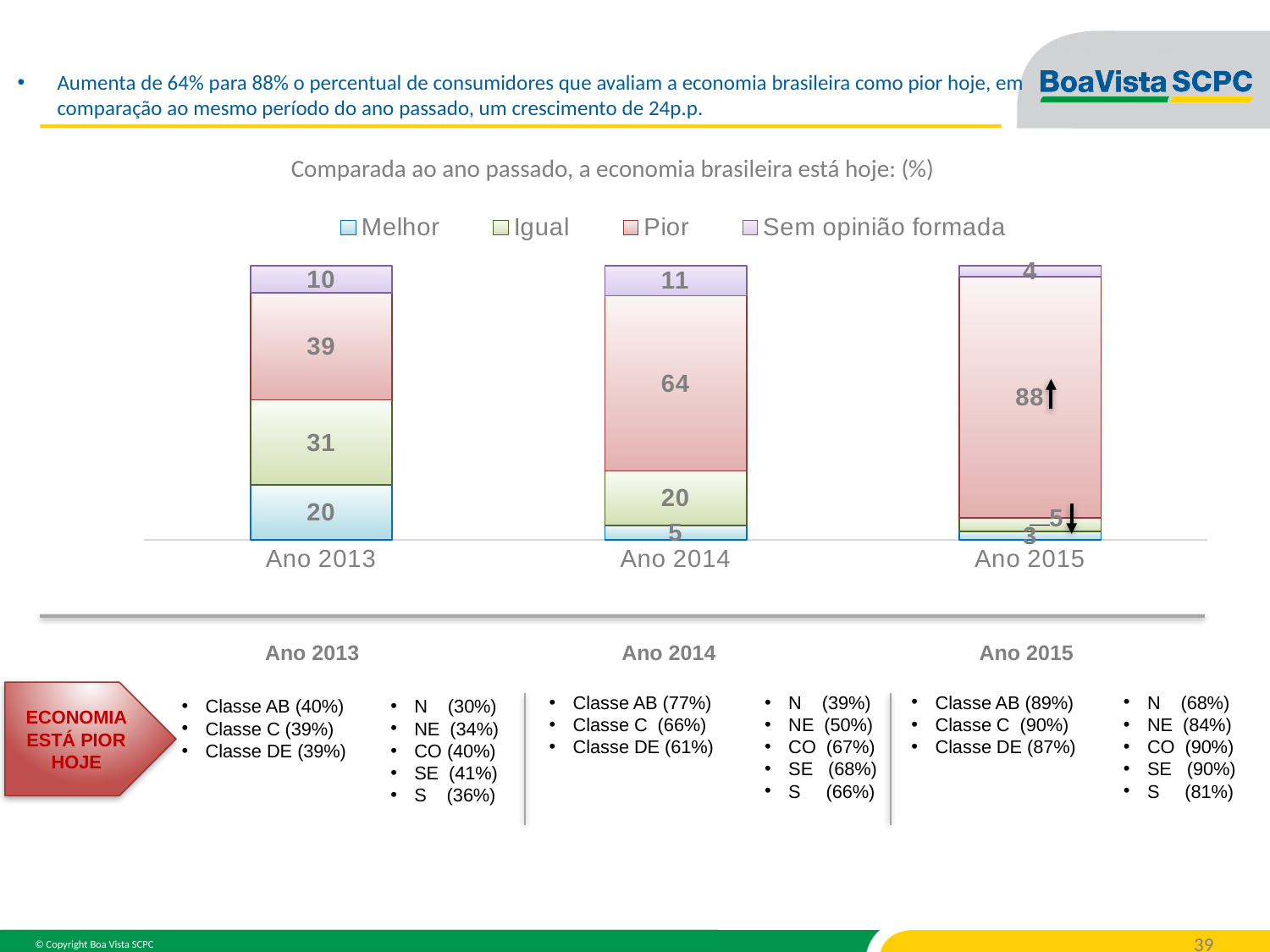
What type of chart is shown on the slide? Stacked bar chart What is the title of the chart? Comparada ao ano passado, a economia brasileira está hoje: (%) What is the value of 'Pior' for Ano 2014? 64 What is the value of 'Igual' for Ano 2015? 5 What is the value of 'Melhor' for Ano 2013? 20 In which year is the 'Melhor' value lowest? Ano 2015 What is the value of 'Sem opinião formada' for Ano 2014? 11 In which year is the 'Pior' value highest? Ano 2015 How many series does the chart legend list? 4 Does the 'Pior' value rise or fall from Ano 2013 to Ano 2015? Rise How many categories (years) are shown on the x axis of the chart? 3 What is the difference between the 'Pior' values for Ano 2015 and Ano 2014? 24